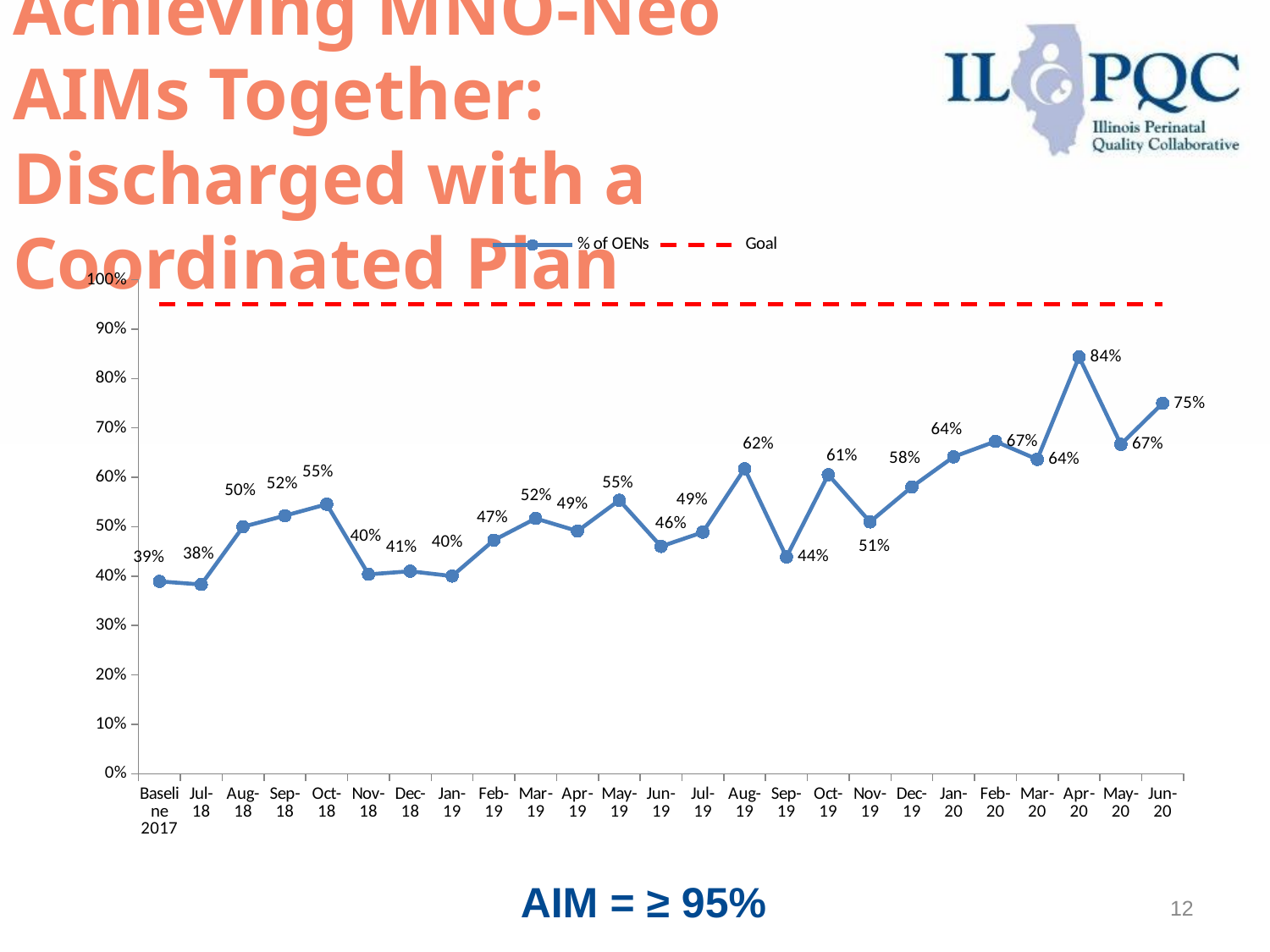
What is the difference between the % of OENs for Apr-20 and Jun-20? 9% What is the % of OENs value for Jun-20? 75% What is the % of OENs value for Apr-20? 84% How many data points are plotted on the % of OENs line? 25 How many series does the legend list? 2 What kind of chart is shown on the slide? Line chart Which month has the lowest % of OENs? Jul-18 What is the % of OENs value for Sep-19? 44% Is the % of OENs value for Jan-20 greater or less than 60%? greater Which is larger, the % of OENs for Aug-19 or Oct-19? Aug-19 What is the % of OENs value for the Baseline 2017 point? 39% Which month has the highest % of OENs? Apr-20